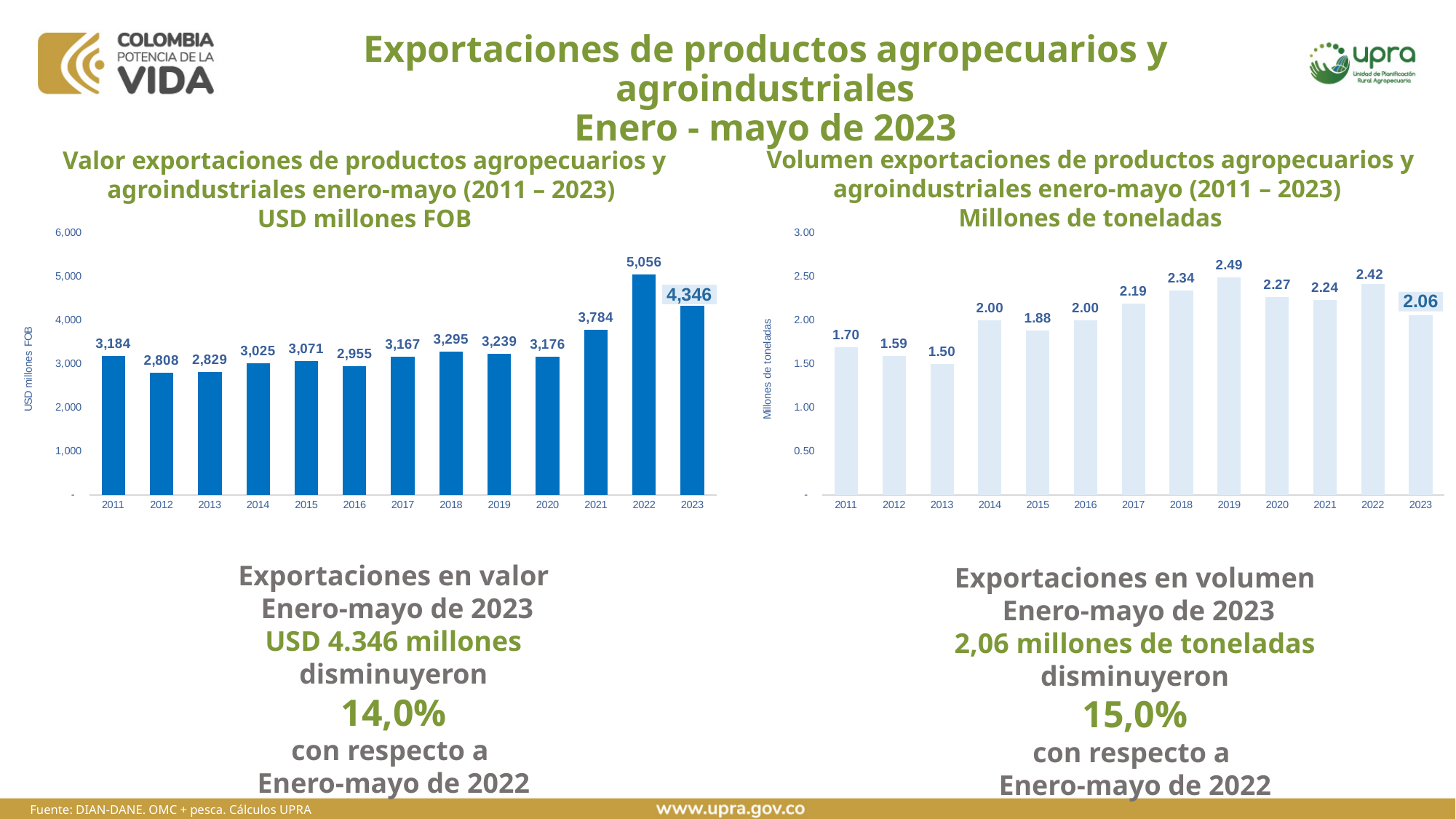
What kind of chart is the right chart (Volumen exportaciones, Millones de toneladas)? bar chart How many years are shown on the x axis of the left chart (Valor exportaciones, USD millones FOB)? 13 In the right chart (Volumen exportaciones, Millones de toneladas), what is the value for 2019? 2.49 In the left chart (Valor exportaciones, USD millones FOB), what is the difference between the 2022 and 2023 values? 710 In the left chart (Valor exportaciones, USD millones FOB), which year has the highest value? 2022 In the left chart (Valor exportaciones, USD millones FOB), do the values rise or fall from 2020 to 2022? rise In the left chart (Valor exportaciones, USD millones FOB), what is the value for 2023? 4,346 In the right chart (Volumen exportaciones, Millones de toneladas), is the value for 2021 greater or less than 2.00? greater In the left chart (Valor exportaciones, USD millones FOB), which year has the larger value, 2012 or 2016? 2016 In the right chart (Volumen exportaciones, Millones de toneladas), which year has the lowest value? 2013 What is the y-axis label of the right chart (Volumen exportaciones)? Millones de toneladas In the right chart (Volumen exportaciones, Millones de toneladas), what is the difference between the 2022 and 2023 values? 0.36